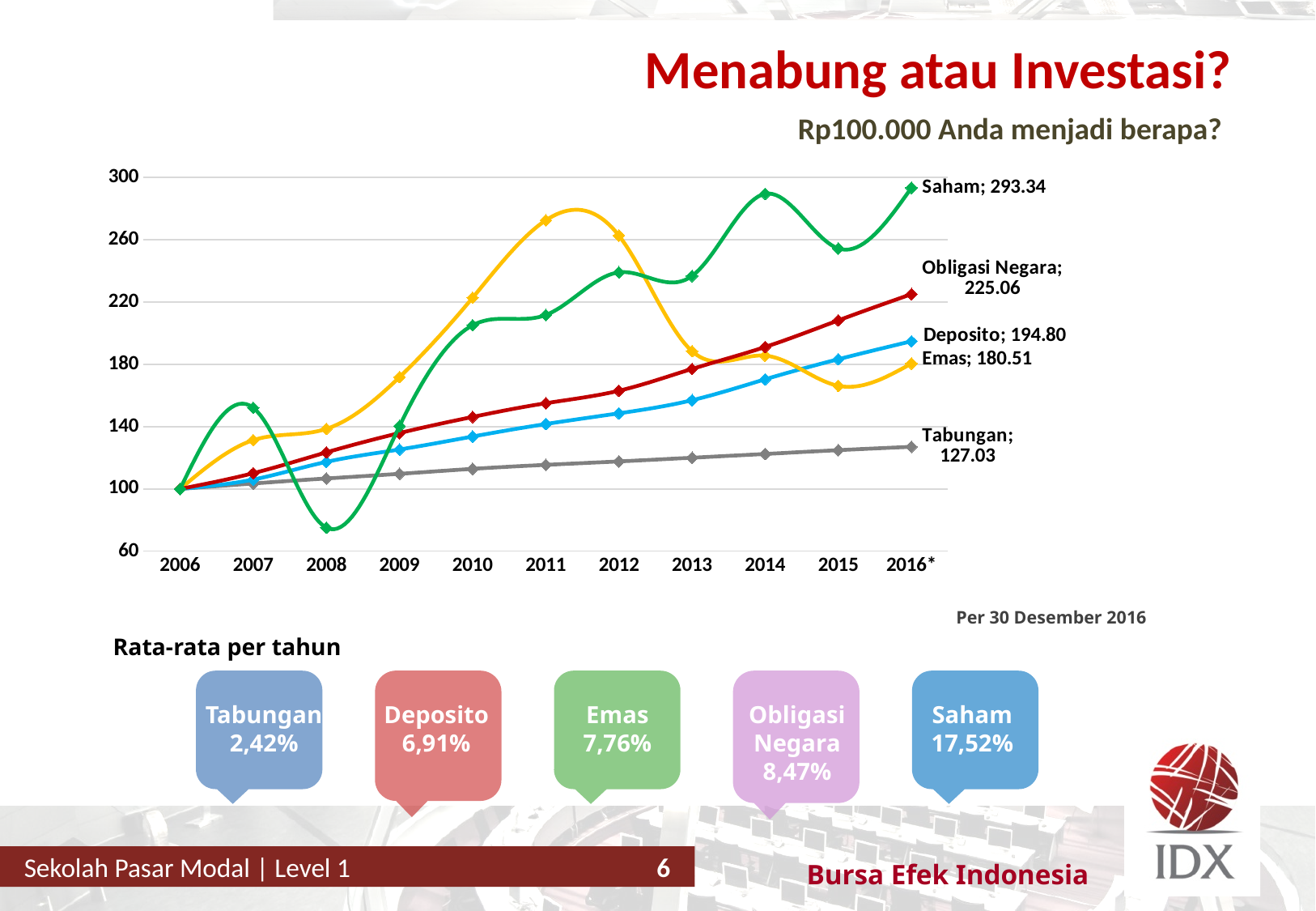
What is the difference between the labelled end values of Saham and Tabungan? 166.31 What is the value labelled for Obligasi Negara at the end of the line chart? 225.06 What is the value labelled for Tabungan at the end of the line chart? 127.03 Which has a larger labelled end value, Obligasi Negara or Deposito? Obligasi Negara What is the value labelled for Saham at the end of the line chart? 293.34 What kind of chart is shown on the slide? Line chart Which series has the lowest labelled value at the end of the chart? Tabungan What is the difference between the labelled end values of Deposito and Emas? 14.29 How many years are shown on the x axis of the chart? 11 Is the value for Saham in 2008 greater or less than 100? less Is the value for Emas in 2011 greater or less than 260? greater Which series has the highest labelled value at the end of the chart? Saham